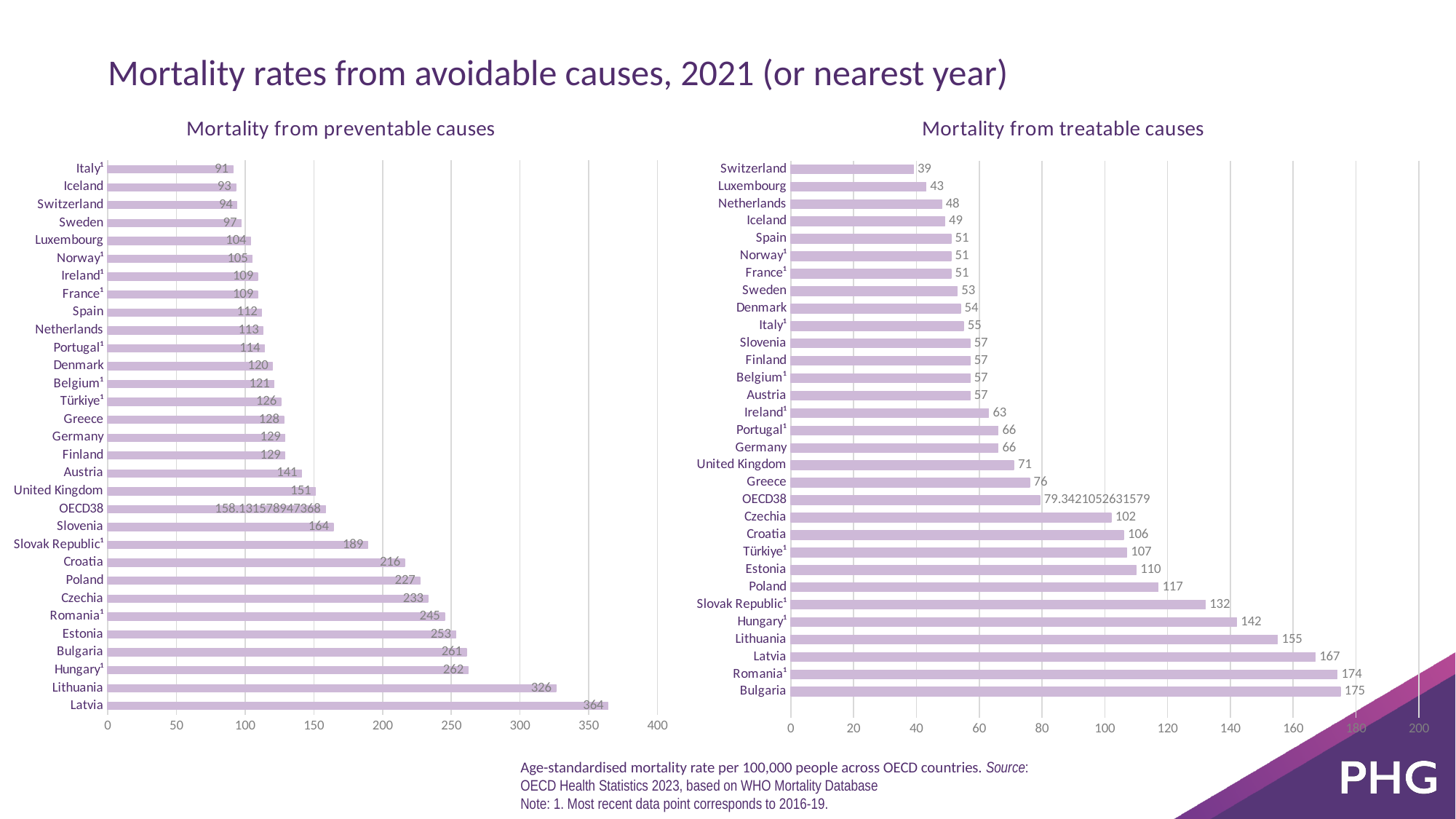
In the 'Mortality from preventable causes' chart, what is the difference between Latvia and Lithuania? 38 In the 'Mortality from treatable causes' chart, what is the value for the United Kingdom? 71 In the 'Mortality from preventable causes' chart, which country has the lowest value? Italy In the 'Mortality from treatable causes' chart, is the value for Czechia greater or less than 100? greater In the 'Mortality from treatable causes' chart, what is the value for Switzerland? 39 How many categories are plotted in the 'Mortality from preventable causes' chart? 31 What kind of chart is the 'Mortality from treatable causes' chart? Bar chart In the 'Mortality from preventable causes' chart, which is larger, the value for Poland or the value for Croatia? Poland What is the title of the slide? Mortality rates from avoidable causes, 2021 (or nearest year) In the 'Mortality from treatable causes' chart, which country has the highest value? Bulgaria In the 'Mortality from preventable causes' chart, what is the value for Latvia? 364 In the 'Mortality from treatable causes' chart, what is the difference between Romania and Hungary? 32